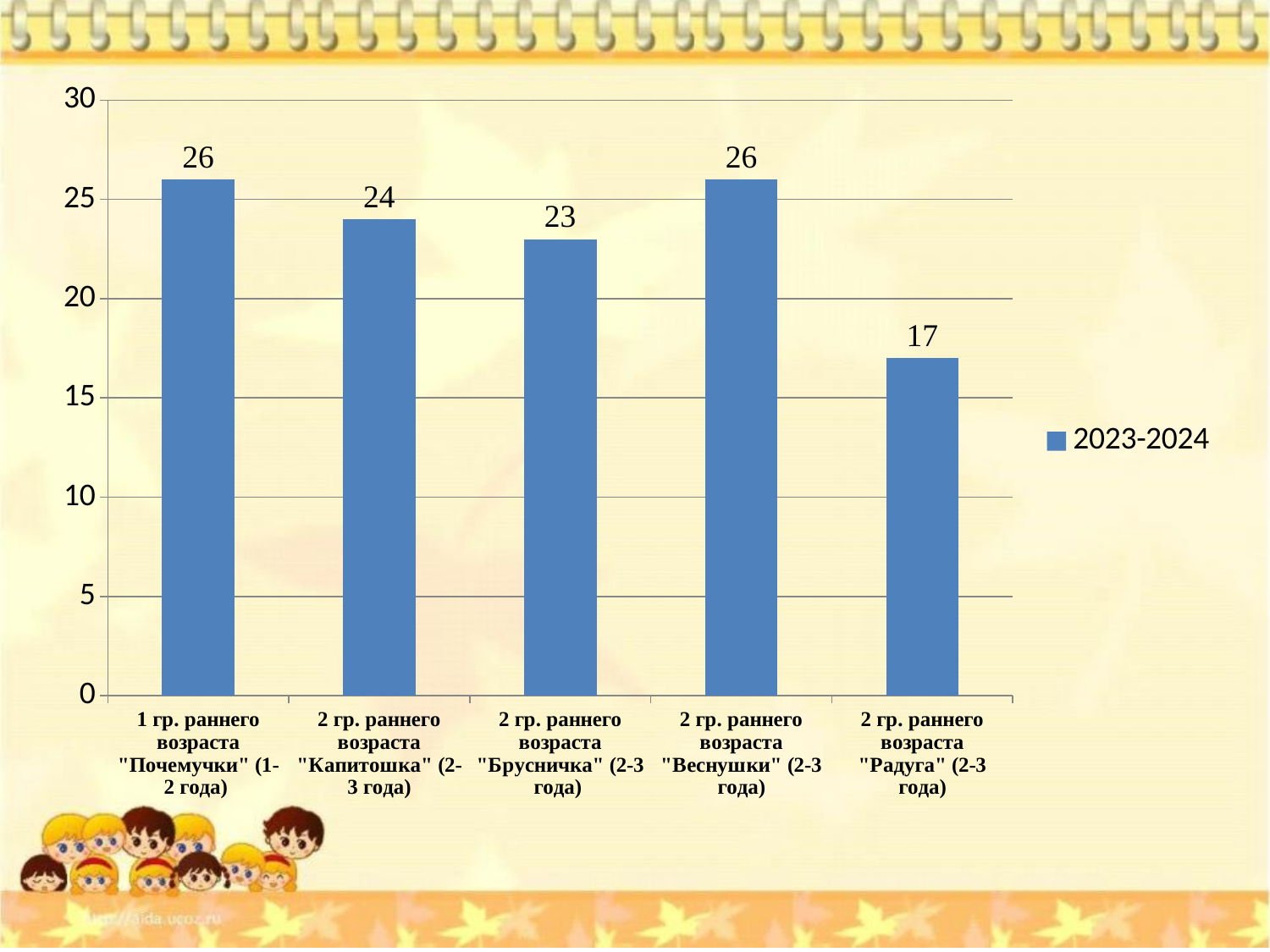
What is the difference between the values for "Капитошка" and "Брусничка"? 1 What is the value for the group "Веснушки" (2-3 года)? 26 Which group has the lowest value? 2 гр. раннего возраста "Радуга" (2-3 года) What is the value for the group "Брусничка" (2-3 года)? 23 Is the value for "Радуга" greater or less than 20? less How many groups are shown on the x axis? 5 What kind of chart is shown on the slide? bar chart What is the value for the group "Радуга" (2-3 года)? 17 What is the value for the group "Капитошка" (2-3 года)? 24 What is the difference between the values for "Почемучки" and "Радуга"? 9 How many series does the legend list? 1 Which is larger, the value for "Почемучки" or the value for "Брусничка"? Почемучки